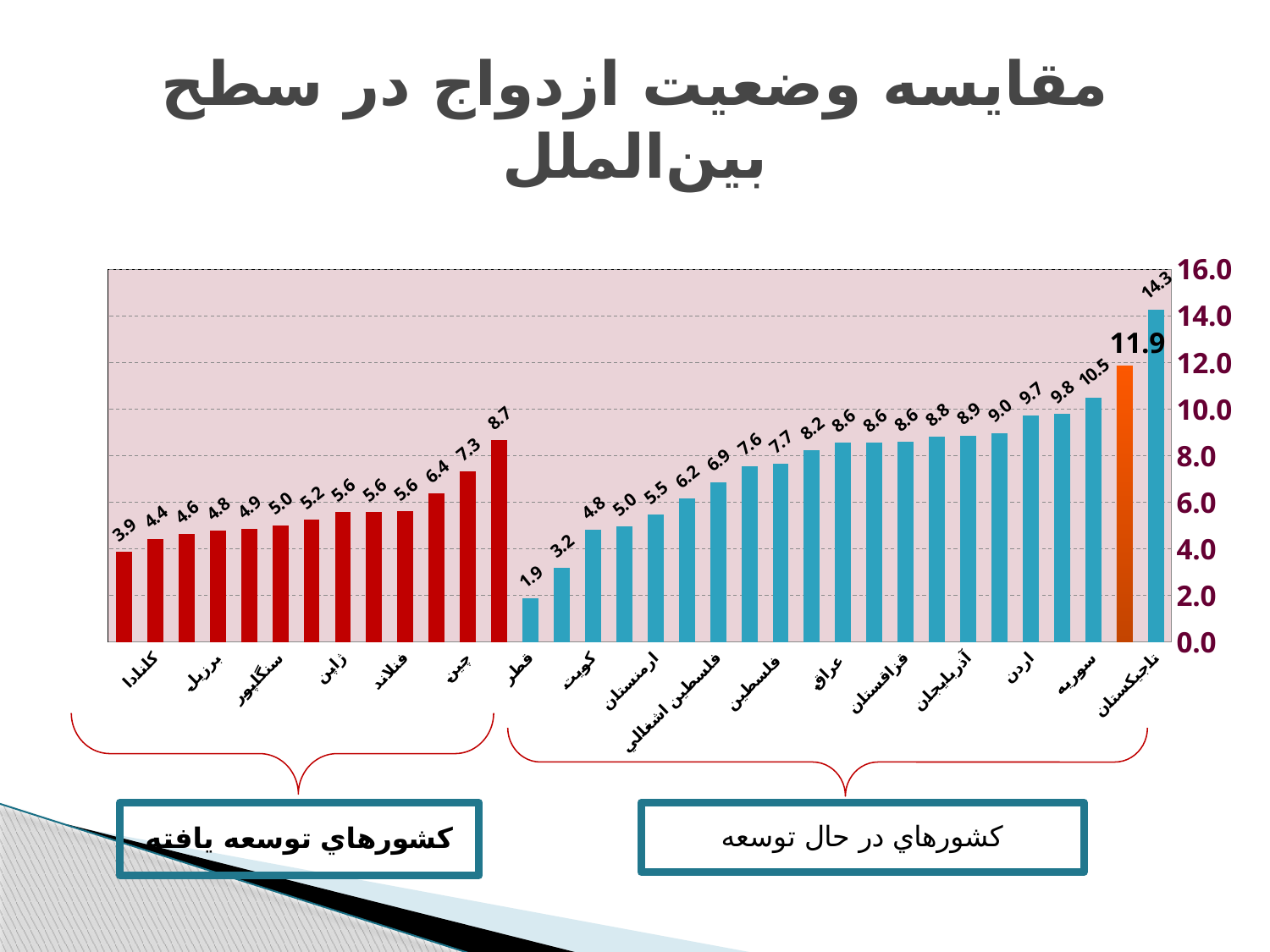
What is the difference between the values for تاجیکستان and کانادا? 9.9 Which has a larger value, سوریه or ژاپن? سوریه What value is shown on the single orange bar? 11.9 What is the value for سوریه? 10.5 Which country has the highest value in the chart? تاجیکستان What is the value for چین? 7.3 What is the value for کانادا? 4.4 Do the values of the blue bars rise or fall from left to right? Rise What is the value for قطر? 1.9 Which country has the lowest value in the chart? قطر What type of chart is shown on the slide? Bar chart What is the value for تاجیکستان? 14.3